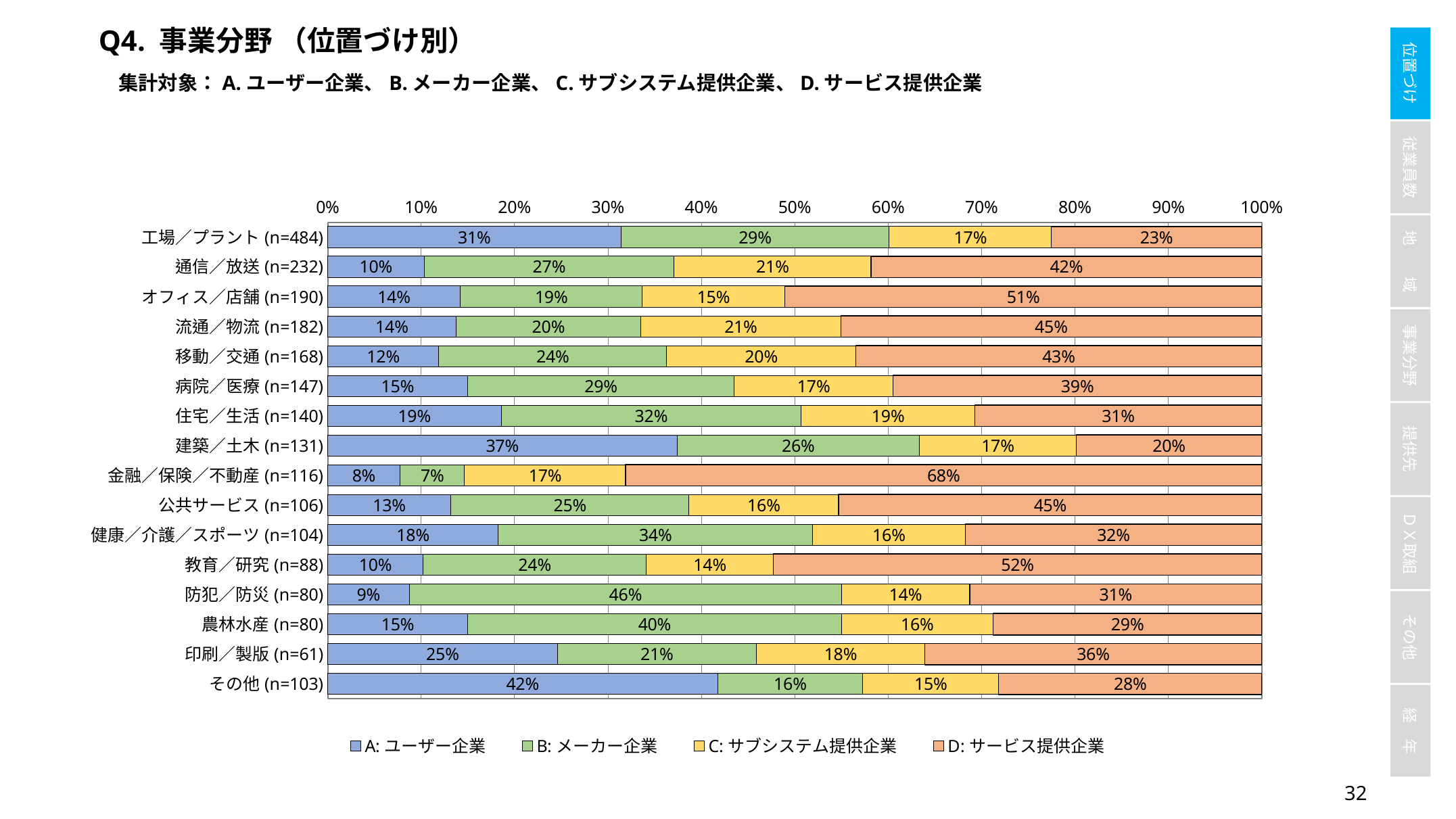
Which is larger: the B: メーカー企業 value for 農林水産 (n=80) or for 健康／介護／スポーツ (n=104)? 農林水産 (n=80) How many series does the legend list? 4 How many business-field categories are plotted on the chart? 16 What is the difference between the D: サービス提供企業 values for オフィス／店舗 (n=190) and 工場／プラント (n=484)? 28% Which category has the highest value for A: ユーザー企業? その他 (n=103) What is the value for D: サービス提供企業 in the 金融／保険／不動産 (n=116) category? 68% What kind of chart is shown on the slide? Stacked bar chart Which category has the lowest value for A: ユーザー企業? 金融／保険／不動産 (n=116) What is the value for A: ユーザー企業 in the 建築／土木 (n=131) category? 37% What is the value for B: メーカー企業 in the 防犯／防災 (n=80) category? 46% What is the label of the series shown in orange in the legend? D: サービス提供企業 Which category has the highest value for D: サービス提供企業? 金融／保険／不動産 (n=116)